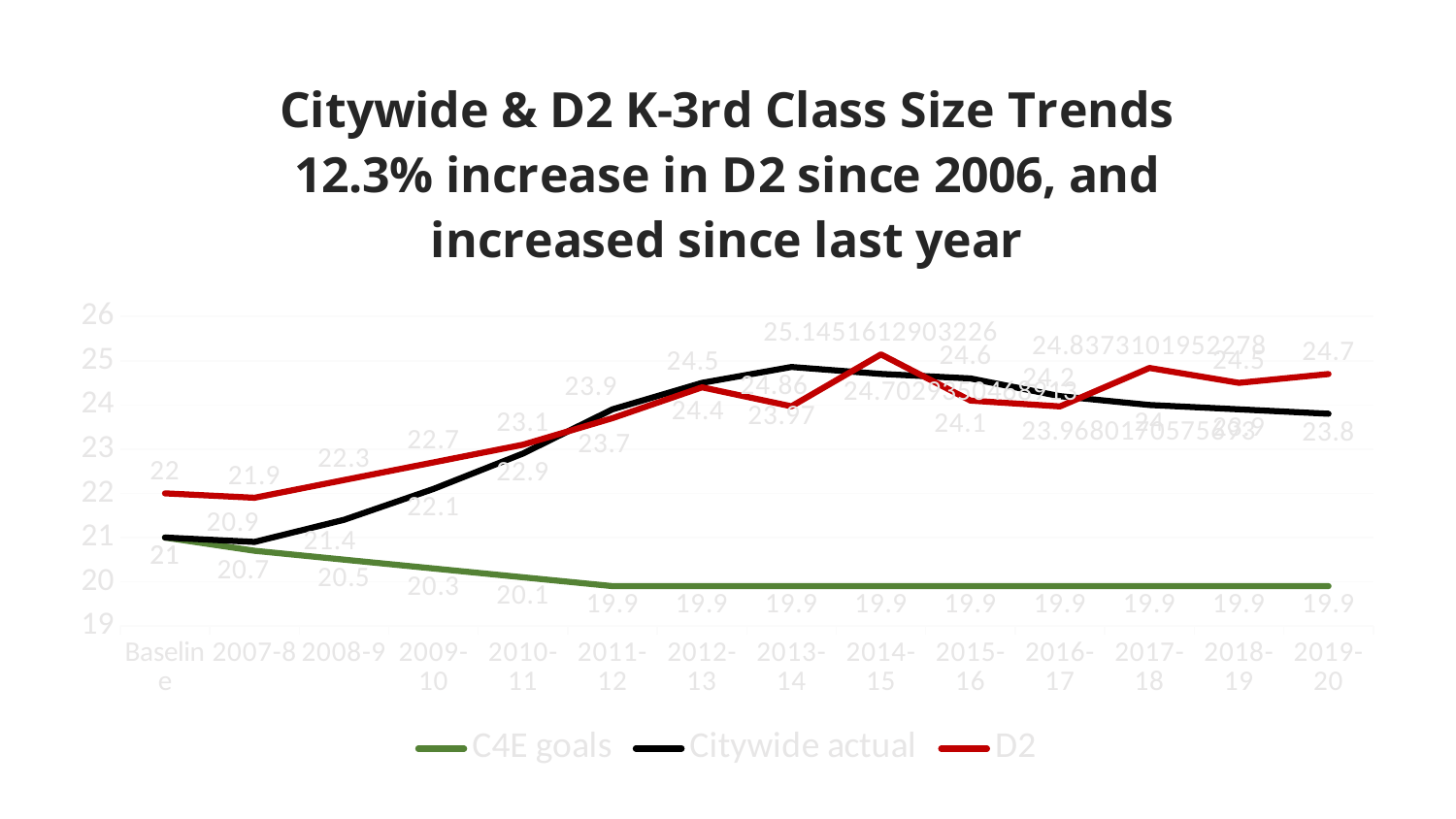
What is the D2 value at Baseline? 22 What is the D2 value for 2019-20? 24.7 What kind of chart is shown on the slide? line chart For 2019-20, which is larger: the D2 value or the Citywide actual value? D2 What is the Citywide actual value for 2019-20? 23.8 How many series does the legend list? 3 In which year does the D2 series reach its highest value? 2014-15 What is the C4E goals value for 2019-20? 19.9 Is the D2 value for 2014-15 greater or less than 25? greater How many categories are shown along the x axis? 14 In which year does the D2 series have its lowest value? 2007-8 What is the difference between the D2 value and the Citywide actual value for 2019-20? 0.9